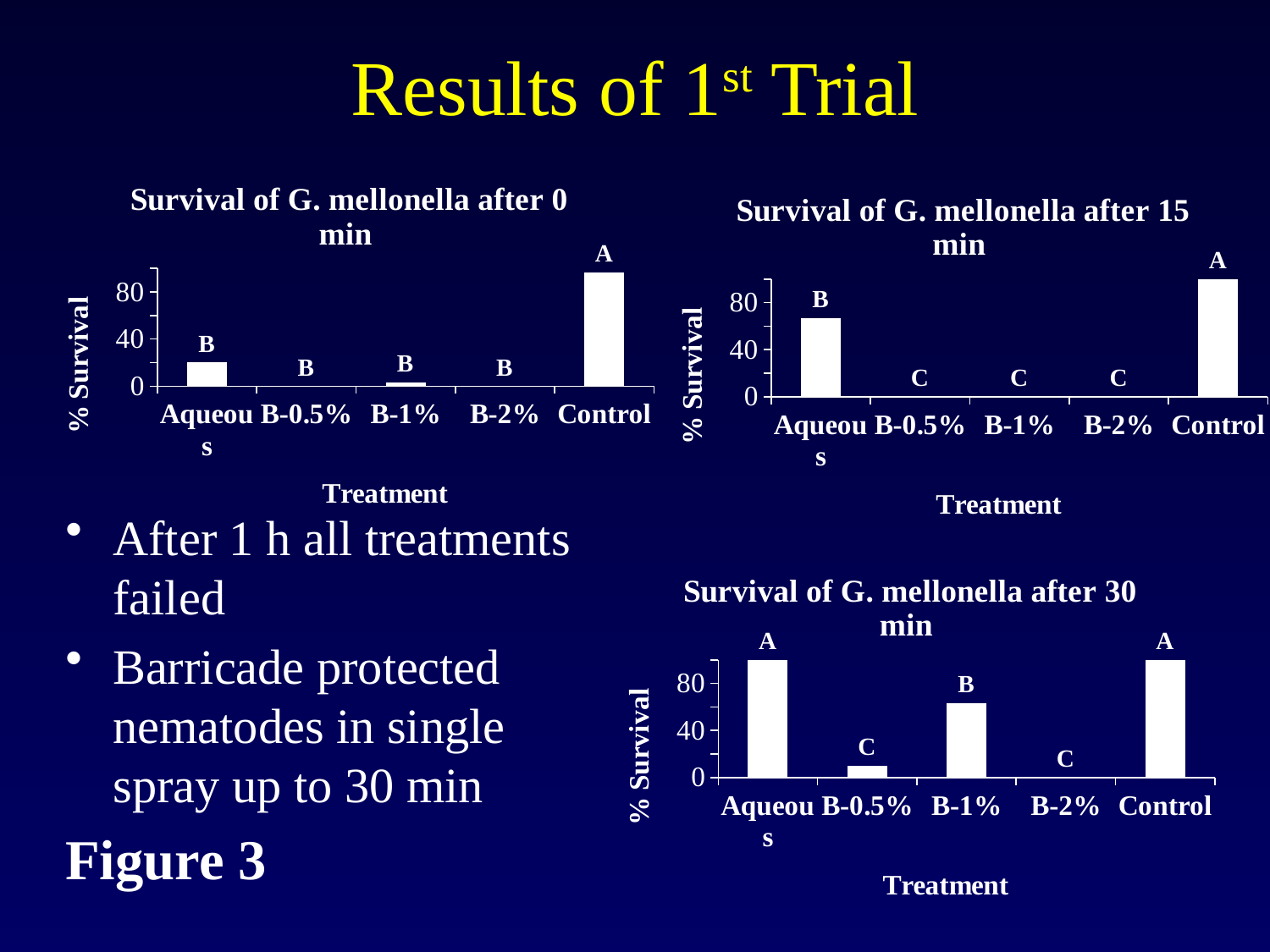
In the 'Survival of G. mellonella after 30 min' chart, is the value for B-1% greater or less than 40? greater In the 'Survival of G. mellonella after 0 min' chart, which treatment has the highest % survival? Control In the 'Survival of G. mellonella after 15 min' chart, is the value for Aqueous greater or less than 40? greater How many treatment categories are shown on the x axis of the 'Survival of G. mellonella after 30 min' chart? 5 In the 'Survival of G. mellonella after 0 min' chart, is the value for Aqueous greater or less than 40? less In the 'Survival of G. mellonella after 15 min' chart, which treatment has the highest % survival? Control In the 'Survival of G. mellonella after 30 min' chart, which has the larger % survival, B-0.5% or B-1%? B-1% What is the y-axis title of the 'Survival of G. mellonella after 30 min' chart? % Survival In the 'Survival of G. mellonella after 15 min' chart, which has the larger % survival, Aqueous or Control? Control What is the x-axis title of the 'Survival of G. mellonella after 0 min' chart? Treatment What kind of chart is 'Survival of G. mellonella after 0 min'? bar chart